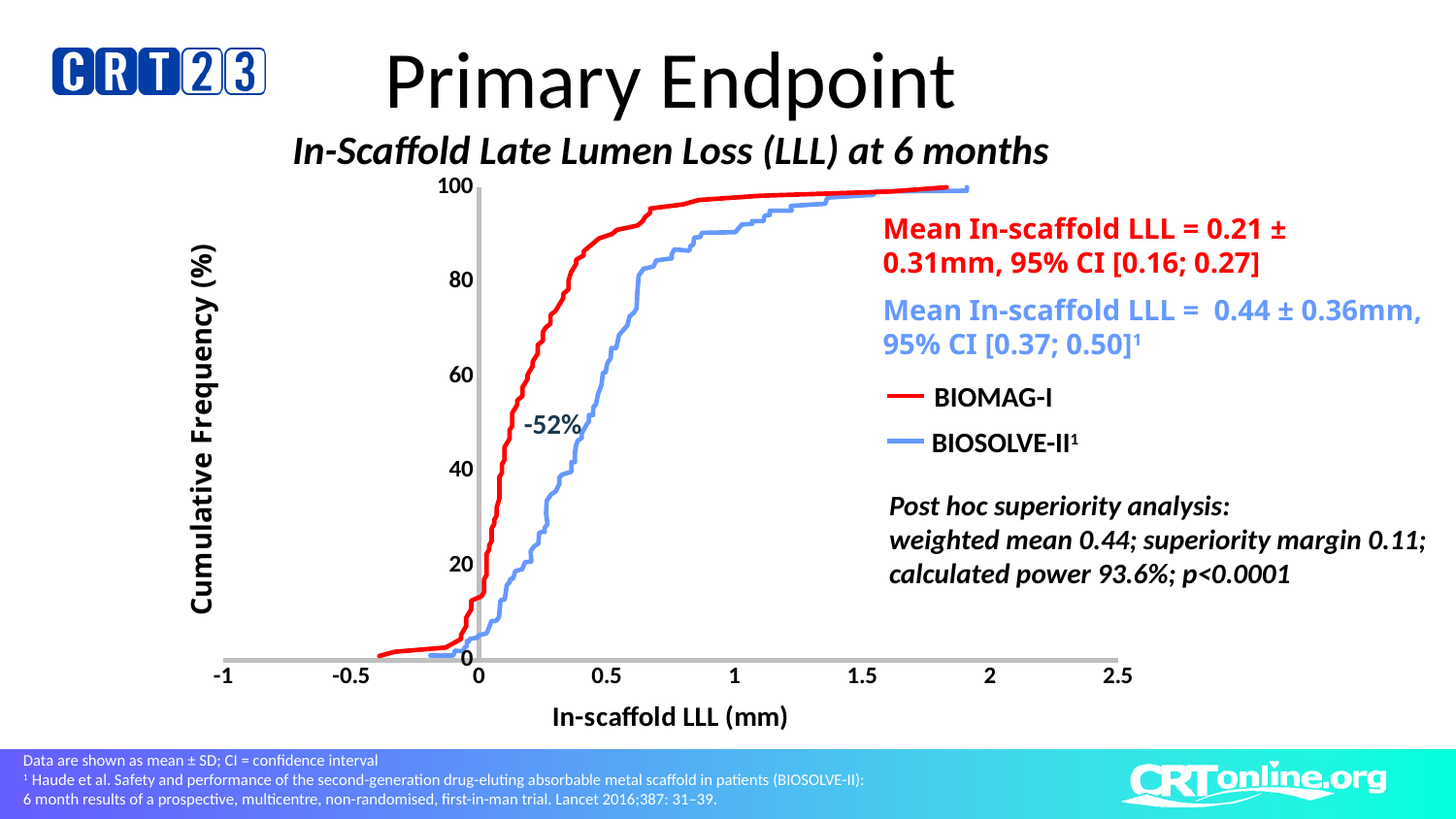
What is the mean In-scaffold LLL reported for BIOSOLVE-II? 0.44 ± 0.36mm What kind of chart is shown on the slide? line chart At an In-scaffold LLL of 0.5 mm, which series has the higher cumulative frequency, BIOMAG-I or BIOSOLVE-II? BIOMAG-I What is the 95% CI reported for the BIOMAG-I mean In-scaffold LLL? [0.16; 0.27] How many series does the legend list? 2 Which series is drawn in red? BIOMAG-I At an In-scaffold LLL of 0.5 mm, is the cumulative frequency for BIOMAG-I greater or less than 80? greater What is the label of the y axis? Cumulative Frequency (%) Do the cumulative frequency curves rise or fall as In-scaffold LLL increases along the x axis? rise At an In-scaffold LLL of 0.25 mm, is the cumulative frequency for BIOSOLVE-II greater or less than 40? less What is the mean In-scaffold LLL reported for BIOMAG-I? 0.21 ± 0.31mm